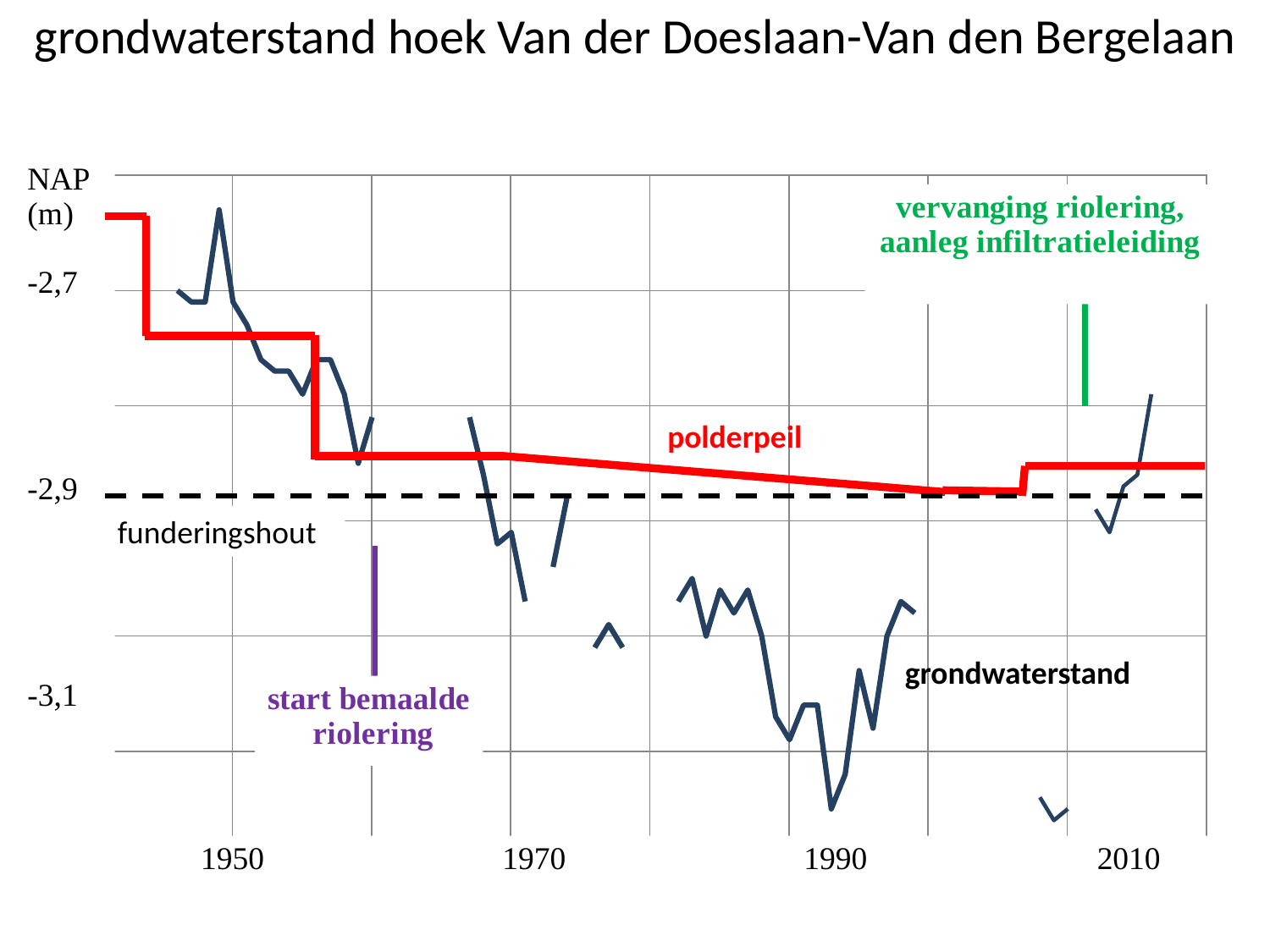
Is the polderpeil value around 1970 greater or less than -2,9? greater Around 1990, which is higher: the polderpeil or the grondwaterstand? polderpeil How many year labels are shown on the x axis? 4 What kind of chart is shown on the slide? line chart Is the grondwaterstand value around 1990 greater or less than -3,1? less Does the grondwaterstand rise or fall between 1950 and 1990? fall At what NAP level (m) is the dashed funderingshout line drawn? -2,9 Which series is drawn in red? polderpeil What is the title of the chart? grondwaterstand hoek Van der Doeslaan-Van den Bergelaan Which event is marked by the purple vertical line? start bemaalde riolering Does the polderpeil rise or fall between 1950 and 1990? fall